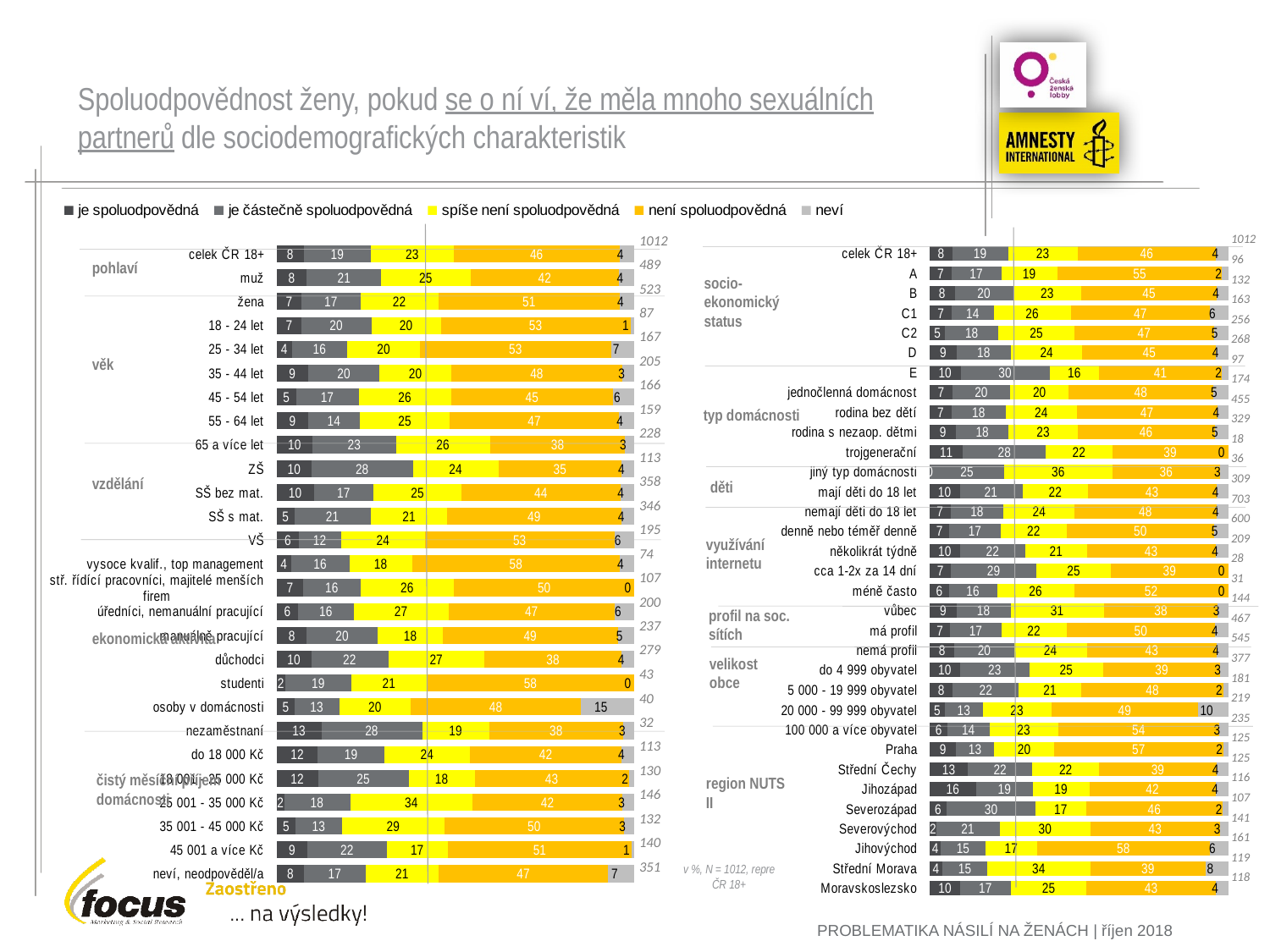
In the left chart, what is the value of 'je částečně spoluodpovědná' for 'ZŠ'? 28 What kind of chart is shown on the slide? stacked bar chart In the right chart, what is the value of 'neví' for 'Střední Morava'? 8 How many series does the legend list? 5 In the left chart, what is the value of 'neví' for 'osoby v domácnosti'? 15 In the left chart, what is the total of the stacked bar for 'celek ČR 18+'? 100 In the left chart, what is the value of 'není spoluodpovědná' for 'celek ČR 18+'? 46 In the right chart, what is the value of 'je částečně spoluodpovědná' for socio-economic status 'E'? 30 In the left chart, what is the difference between the 'není spoluodpovědná' values for 'žena' and 'muž'? 9 In the right chart, what is the value of 'není spoluodpovědná' for 'Praha'? 57 In the left chart, which is larger for 'nezaměstnaní': 'je spoluodpovědná' or 'je částečně spoluodpovědná'? je částečně spoluodpovědná In the left chart, which response category has the largest value for 'studenti'? není spoluodpovědná